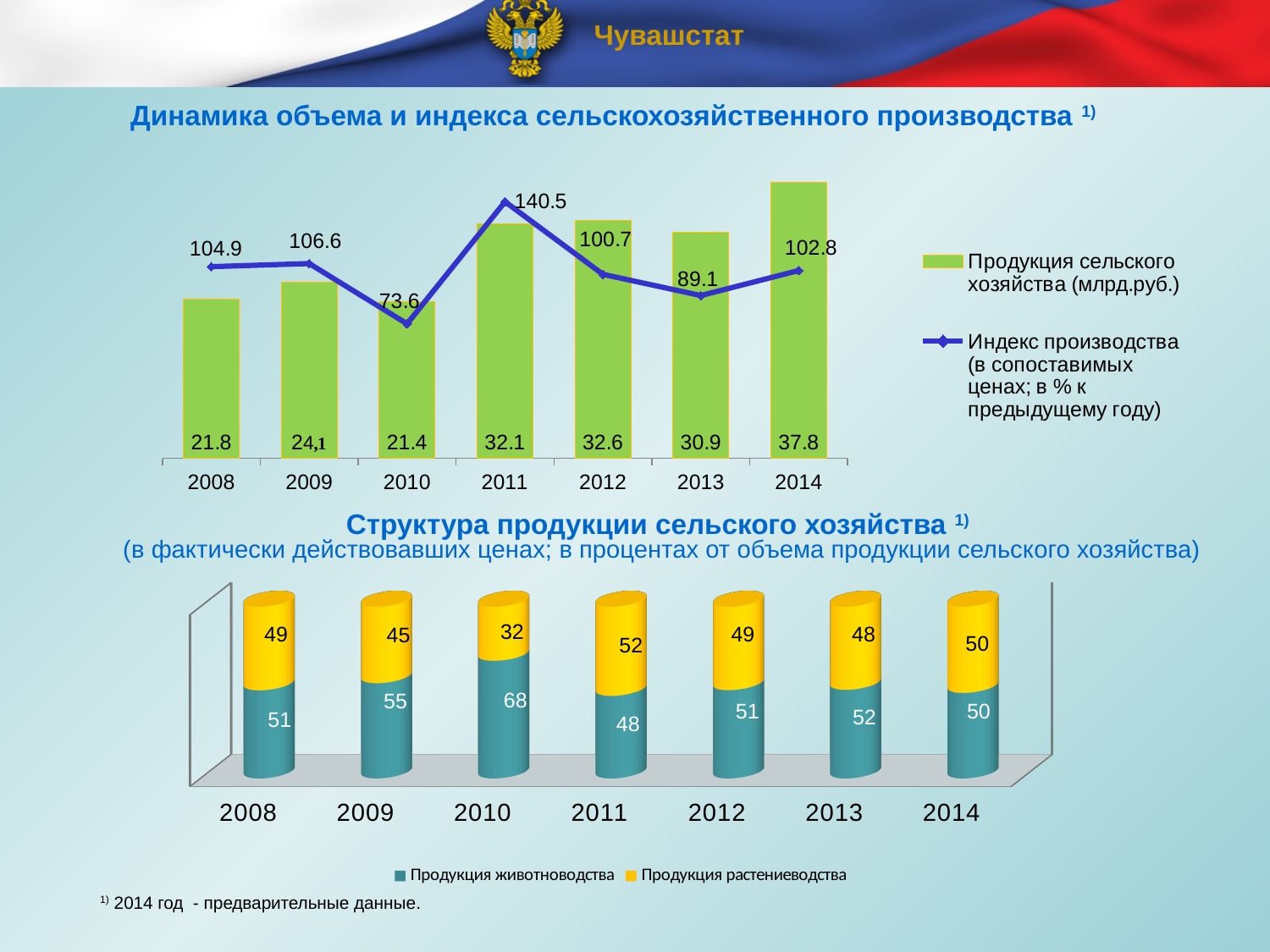
In the bottom chart 'Структура продукции сельского хозяйства', what is the total of the two segments for 2009? 100 In the top chart 'Динамика объема и индекса сельскохозяйственного производства', which year has the highest value of 'Продукция сельского хозяйства (млрд.руб.)'? 2014 In the top chart 'Динамика объема и индекса сельскохозяйственного производства', how many years are shown on the x axis? 7 In the top chart 'Динамика объема и индекса сельскохозяйственного производства', which year has the lowest value of 'Индекс производства'? 2010 In the top chart 'Динамика объема и индекса сельскохозяйственного производства', what is the difference between the 'Продукция сельского хозяйства' values for 2014 and 2013? 6.9 In the top chart 'Динамика объема и индекса сельскохозяйственного производства', how many series does the legend list? 2 In the top chart 'Динамика объема и индекса сельскохозяйственного производства', what is the value of 'Индекс производства' for 2011? 140.5 What type of chart is the bottom chart 'Структура продукции сельского хозяйства'? Stacked bar chart In the bottom chart 'Структура продукции сельского хозяйства', which year has the highest share of 'Продукция растениеводства'? 2011 In the top chart 'Динамика объема и индекса сельскохозяйственного производства', what is the value of 'Продукция сельского хозяйства (млрд.руб.)' for 2014? 37.8 In the bottom chart 'Структура продукции сельского хозяйства', what is the share of 'Продукция животноводства' in 2010? 68 In the top chart 'Динамика объема и индекса сельскохозяйственного производства', is the 'Индекс производства' value higher in 2012 or in 2013? 2012